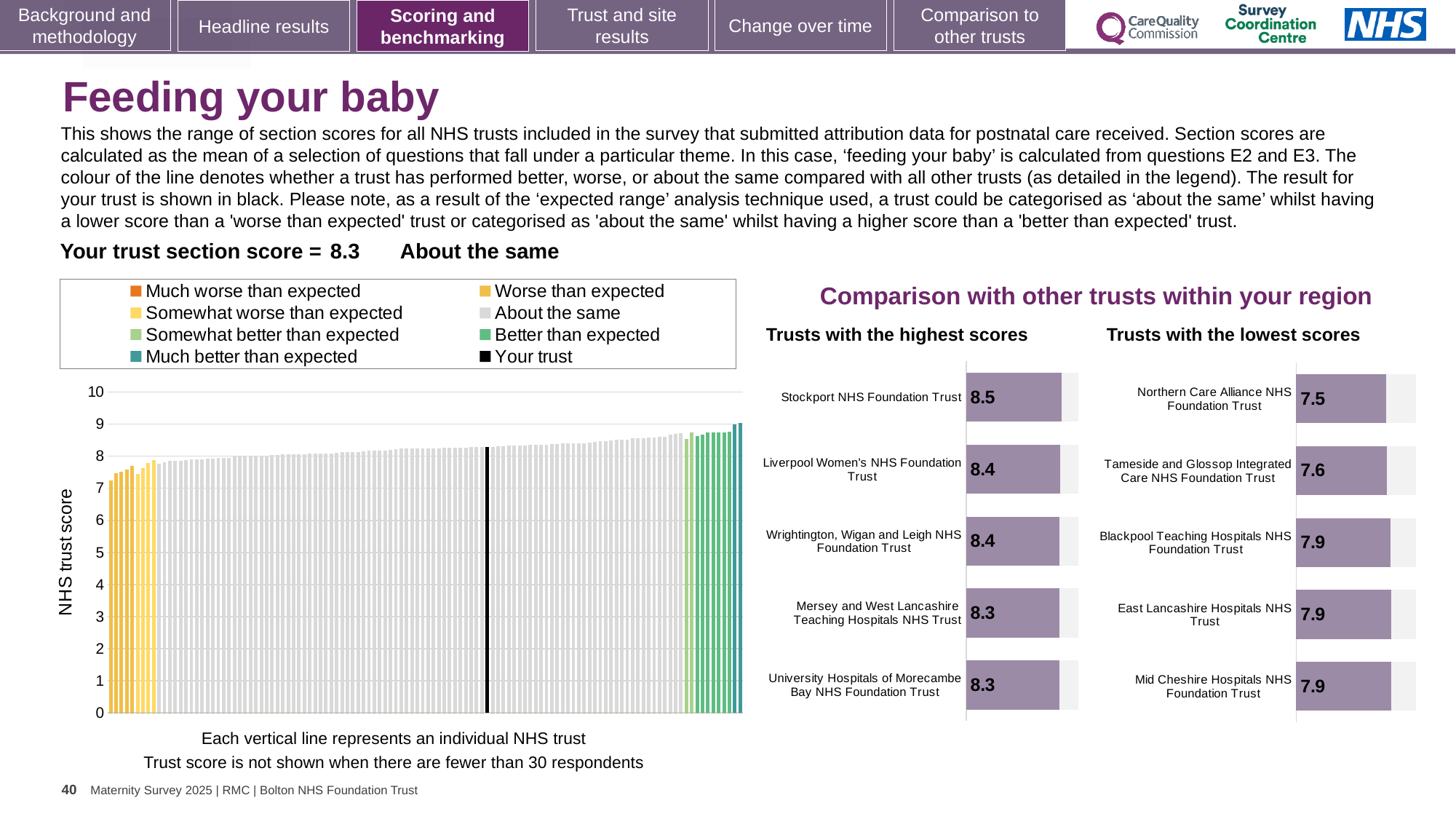
In the large chart on the left, do the trust scores rise or fall from left to right along the x axis? Rise In the 'Trusts with the lowest scores' chart, which has the larger score: Tameside and Glossop Integrated Care NHS Foundation Trust or Northern Care Alliance NHS Foundation Trust? Tameside and Glossop Integrated Care NHS Foundation Trust In the 'Trusts with the highest scores' chart, what is the difference between the scores of Stockport NHS Foundation Trust and University Hospitals of Morecambe Bay NHS Foundation Trust? 0.2 In the 'Trusts with the lowest scores' chart, what is the difference between the scores of Blackpool Teaching Hospitals NHS Foundation Trust and Northern Care Alliance NHS Foundation Trust? 0.4 In the 'Trusts with the lowest scores' chart, what is the score for Northern Care Alliance NHS Foundation Trust? 7.5 In the 'Trusts with the lowest scores' chart, which trust has the lowest score? Northern Care Alliance NHS Foundation Trust What kind of chart is the large chart on the left showing NHS trust scores? Bar chart How many entries does the legend above the large chart on the left list? 8 In the 'Trusts with the lowest scores' chart, what is the score for Mid Cheshire Hospitals NHS Foundation Trust? 7.9 In the 'Trusts with the highest scores' chart, what is the score for Stockport NHS Foundation Trust? 8.5 In the 'Trusts with the highest scores' chart, how many trusts are listed? 5 In the 'Trusts with the highest scores' chart, which trust has the highest score? Stockport NHS Foundation Trust